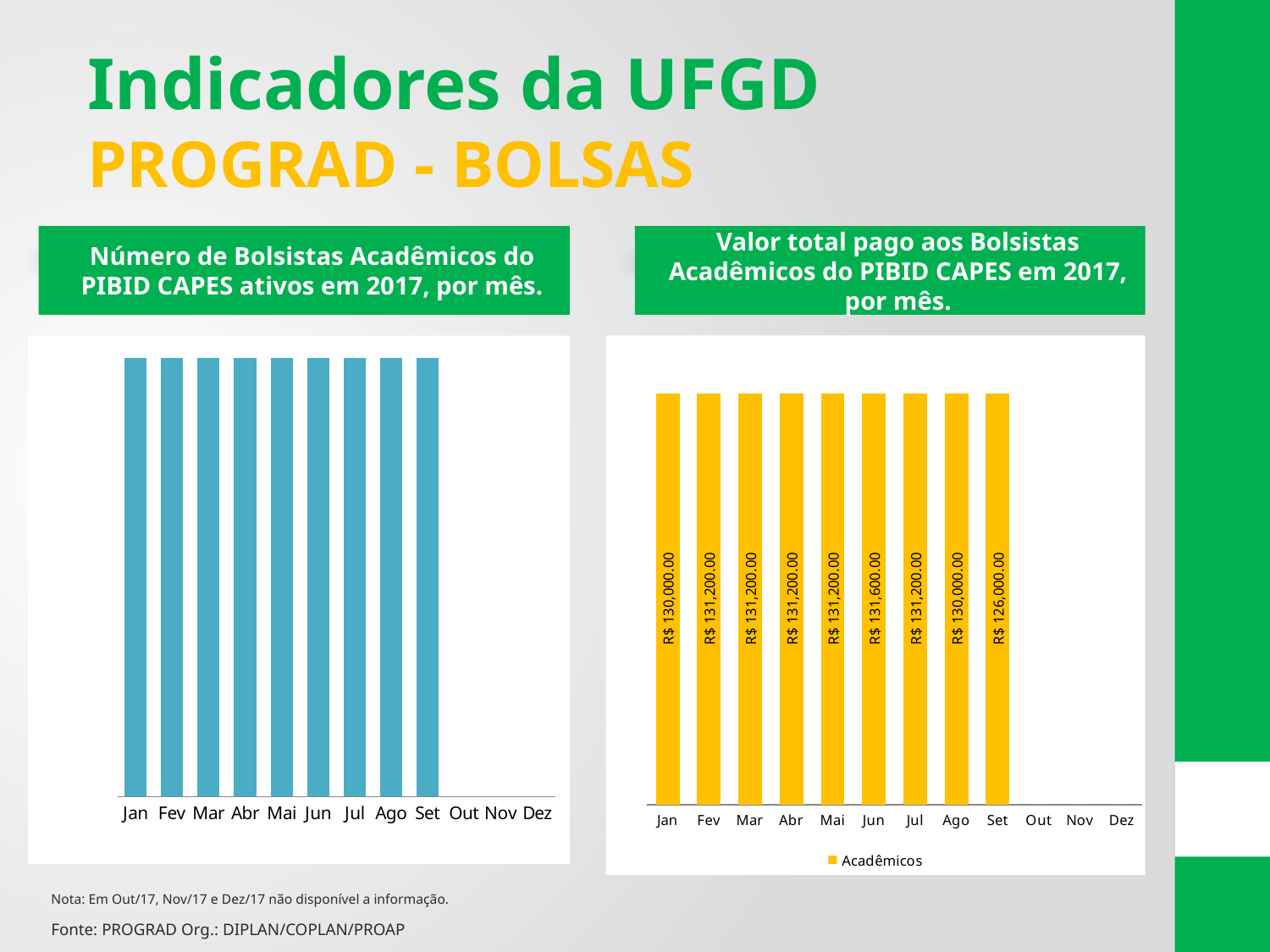
In the chart 'Valor total pago aos Bolsistas Acadêmicos do PIBID CAPES em 2017, por mês', which month has the lowest value among the months with data? Set In the chart 'Valor total pago aos Bolsistas Acadêmicos do PIBID CAPES em 2017, por mês', what is the legend entry? Acadêmicos In the chart 'Valor total pago aos Bolsistas Acadêmicos do PIBID CAPES em 2017, por mês', what is the value for Jan? R$ 130,000.00 In the chart 'Valor total pago aos Bolsistas Acadêmicos do PIBID CAPES em 2017, por mês', which month has the highest value? Jun In the chart 'Valor total pago aos Bolsistas Acadêmicos do PIBID CAPES em 2017, por mês', how many months have a bar plotted? 9 In the chart 'Valor total pago aos Bolsistas Acadêmicos do PIBID CAPES em 2017, por mês', what is the value for Jun? R$ 131,600.00 In the chart 'Valor total pago aos Bolsistas Acadêmicos do PIBID CAPES em 2017, por mês', which is larger, the value for Fev or the value for Ago? Fev In the chart 'Valor total pago aos Bolsistas Acadêmicos do PIBID CAPES em 2017, por mês', how many series does the legend list? 1 What kind of chart is the chart 'Número de Bolsistas Acadêmicos do PIBID CAPES ativos em 2017, por mês'? Bar chart In the chart 'Valor total pago aos Bolsistas Acadêmicos do PIBID CAPES em 2017, por mês', what is the difference between the values for Jun and Set? R$ 5,600.00 In the chart 'Valor total pago aos Bolsistas Acadêmicos do PIBID CAPES em 2017, por mês', what is the value for Mar? R$ 131,200.00 In the chart 'Valor total pago aos Bolsistas Acadêmicos do PIBID CAPES em 2017, por mês', what is the value for Set? R$ 126,000.00